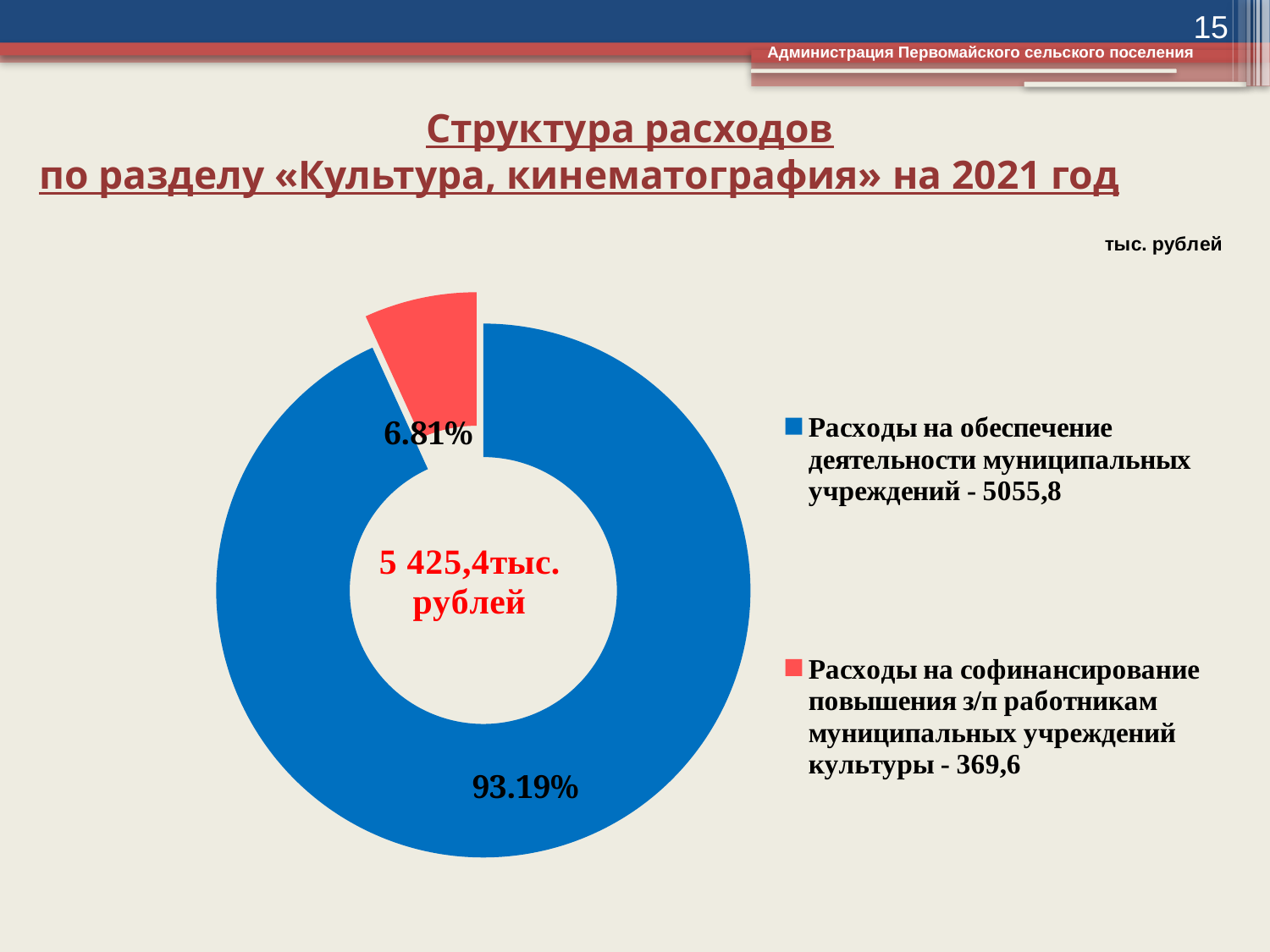
What colour is the slice for «Расходы на софинансирование повышения з/п работникам муниципальных учреждений культуры»? Red How many categories does the chart show? 2 Which category has the largest slice of the chart? Расходы на обеспечение деятельности муниципальных учреждений Which category has the smallest slice of the chart? Расходы на софинансирование повышения з/п работникам муниципальных учреждений культуры What is the difference in percentage points between the two slices of the chart? 86.38% Which is larger: the share for «Расходы на обеспечение деятельности муниципальных учреждений» or the share for «Расходы на софинансирование повышения з/п работникам муниципальных учреждений культуры»? Расходы на обеспечение деятельности муниципальных учреждений What share of the chart does the slice for «Расходы на софинансирование повышения з/п работникам муниципальных учреждений культуры» represent? 6.81% What kind of chart is shown on the slide? Pie chart (doughnut) What share of the chart does the slice for «Расходы на обеспечение деятельности муниципальных учреждений» represent? 93.19% What is the value for «Расходы на софинансирование повышения з/п работникам муниципальных учреждений культуры» according to the legend? 369,6 What is the value for «Расходы на обеспечение деятельности муниципальных учреждений» according to the legend? 5055,8 What total amount is printed in the centre of the chart? 5 425,4тыс. рублей